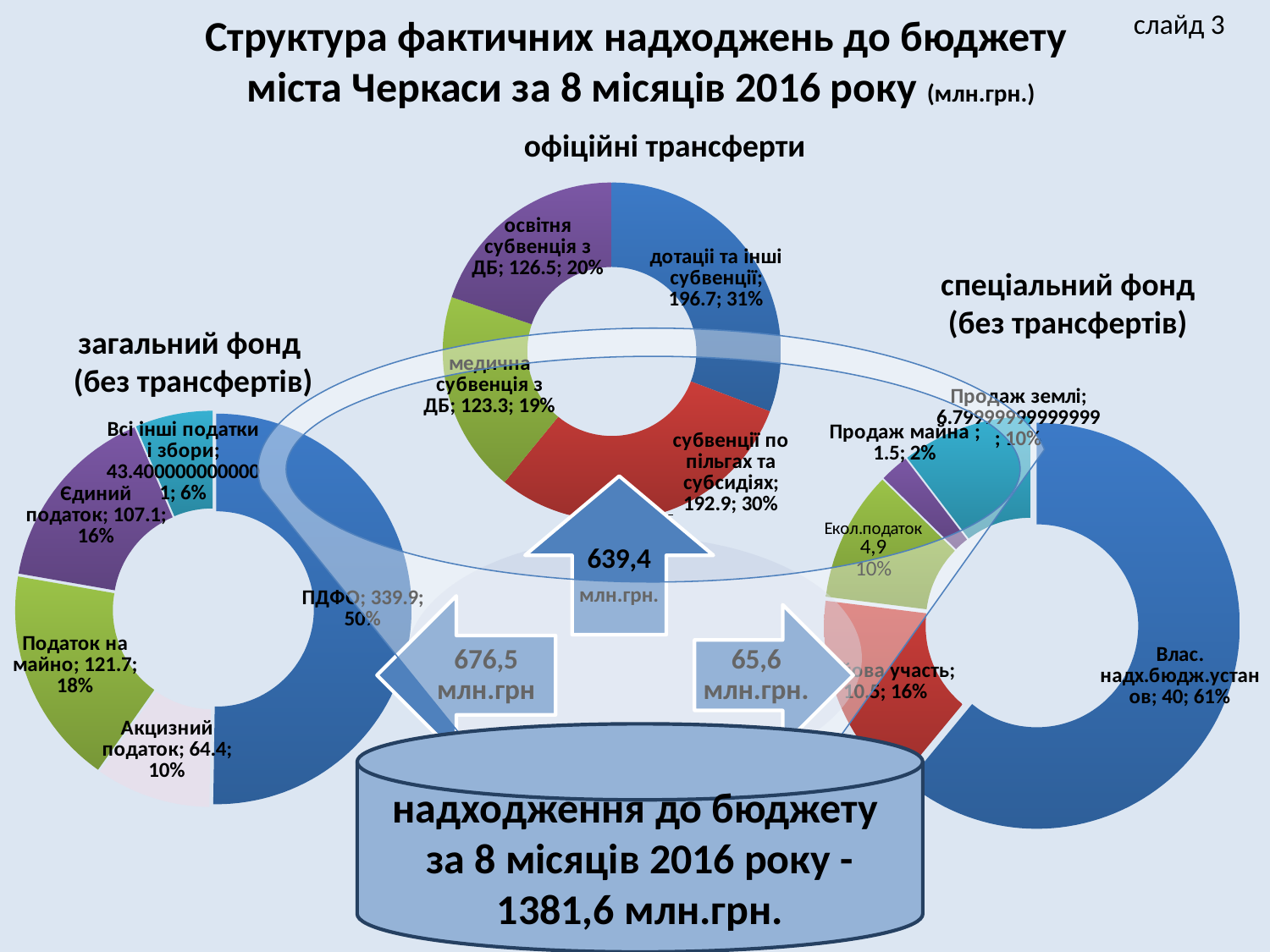
In the 'офіційні трансферти' chart, which category has the largest value? дотації та інші субвенції In the 'загальний фонд (без трансфертів)' chart, what share does 'Податок на майно' have? 18% In the 'офіційні трансферти' chart, what is the difference between 'освітня субвенція з ДБ' and 'медична субвенція з ДБ'? 3.2 In the 'офіційні трансферти' chart, what is the value for 'дотації та інші субвенції'? 196.7 In the 'офіційні трансферти' chart, what share does 'медична субвенція з ДБ' have? 19% In the 'спеціальний фонд (без трансфертів)' chart, what is the value for 'Продаж майна'? 1.5 In the 'загальний фонд (без трансфертів)' chart, how many categories are shown? 5 In the 'загальний фонд (без трансфертів)' chart, which is larger: 'Єдиний податок' or 'Акцизний податок'? Єдиний податок In the 'офіційні трансферти' chart, how many categories are shown? 4 In the 'спеціальний фонд (без трансфертів)' chart, what share does 'Влас. надх.бюдж.установ' have? 61% In the 'загальний фонд (без трансфертів)' chart, what is the value for 'ПДФО'? 339.9 What type of chart is the 'офіційні трансферти' chart? doughnut chart